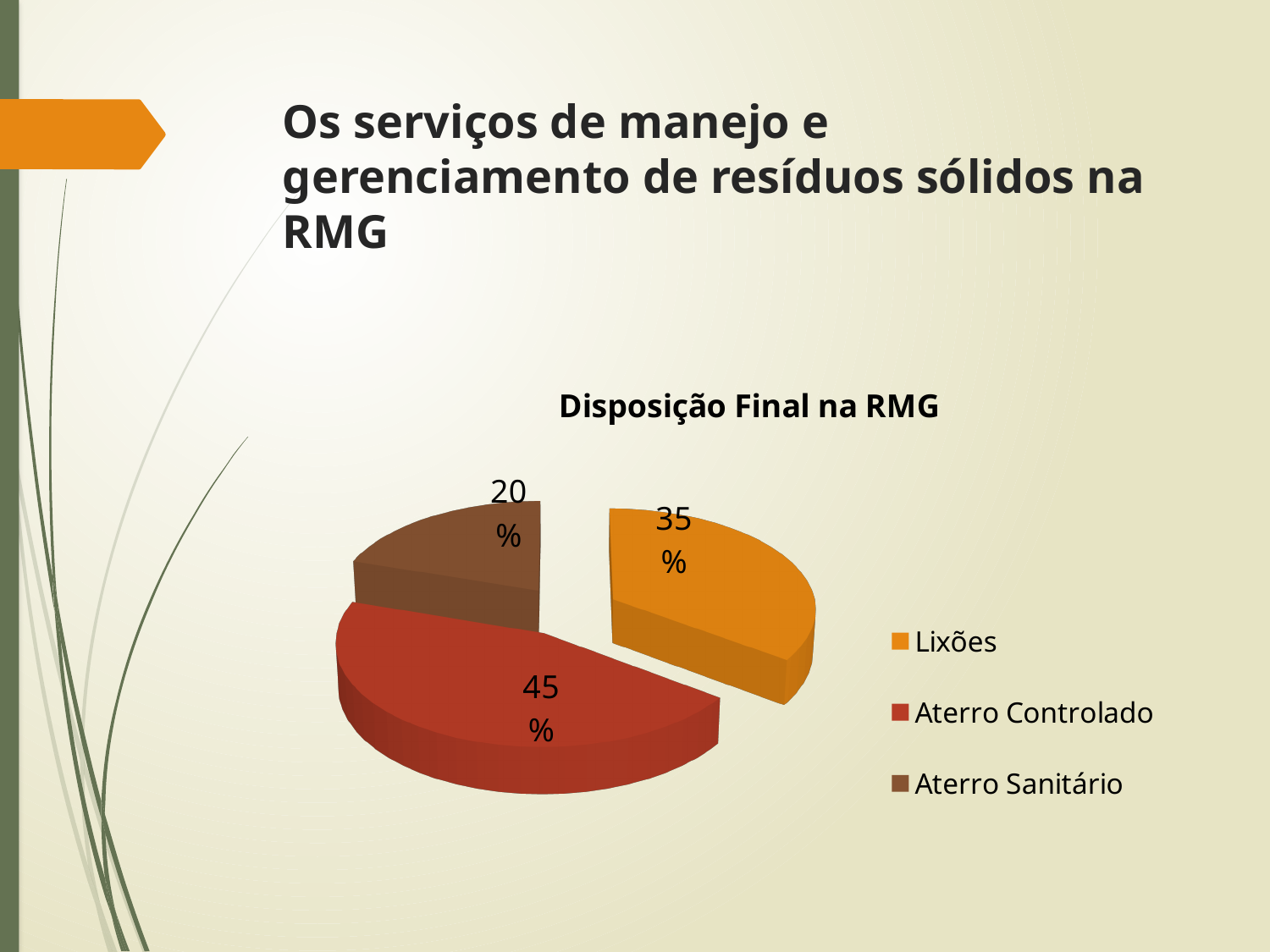
How many categories does the pie chart show? 3 Which colour represents Aterro Sanitário in the legend? brown What share of the pie does Lixões represent? 35% What is the difference between the shares of Aterro Controlado and Lixões? 10% What is the difference between the shares of Lixões and Aterro Sanitário? 15% What share of the pie does Aterro Controlado represent? 45% Which is larger, the share for Lixões or the share for Aterro Sanitário? Lixões What is the title of the chart? Disposição Final na RMG What kind of chart is shown on the slide? pie chart Which category has the smallest slice of the pie? Aterro Sanitário Which category has the largest slice of the pie? Aterro Controlado What share of the pie does Aterro Sanitário represent? 20%